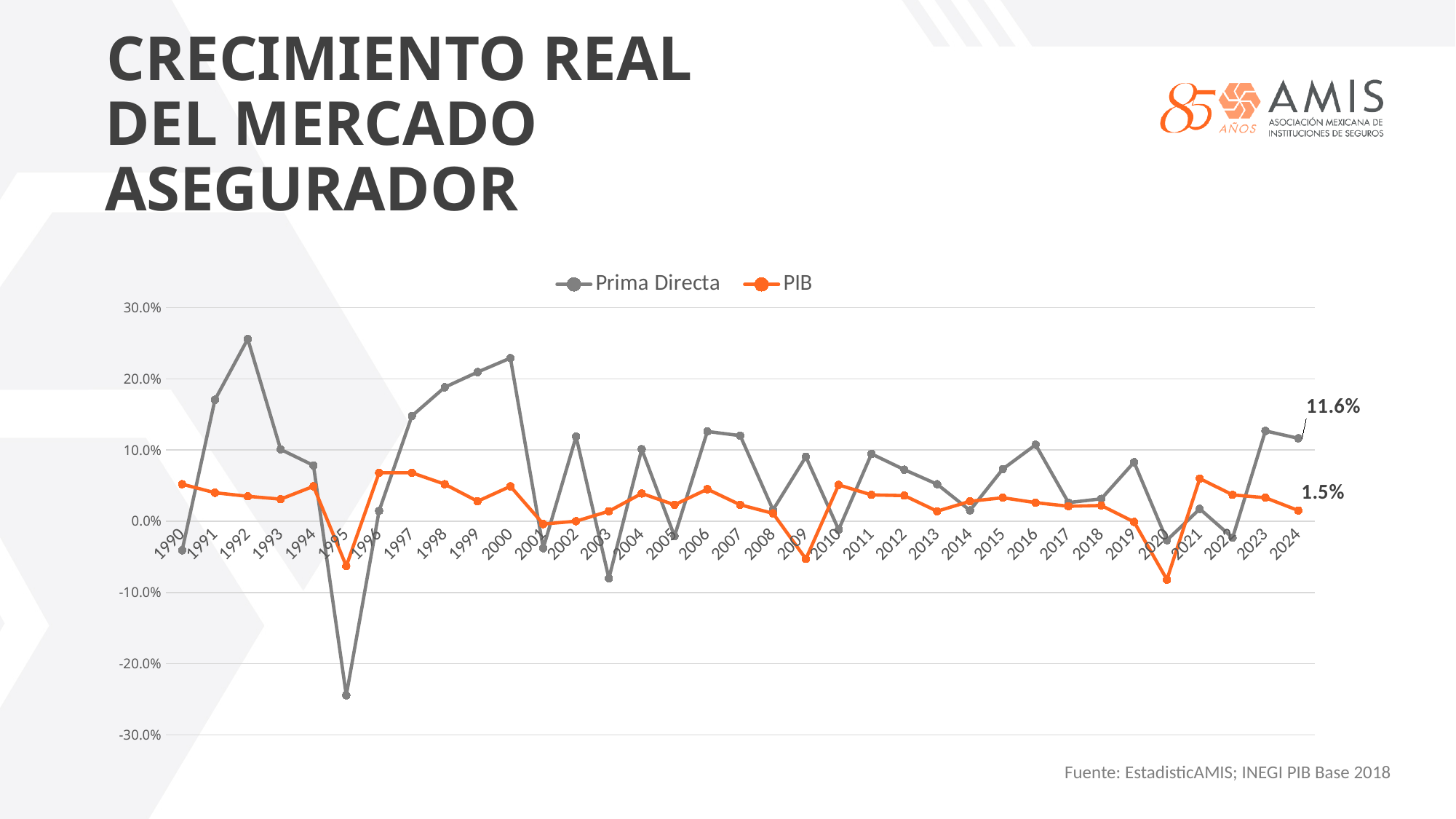
What is the difference between the Prima Directa and PIB values in 2024? 10.1 percentage points Is the PIB value for 2020 greater or less than 0.0%? less In which year does Prima Directa reach its highest value? 1992 In which year does Prima Directa reach its lowest value? 1995 What is the PIB value for 2024? 1.5% Is the Prima Directa value for 1992 greater or less than 20.0%? greater How many years are shown on the x axis? 35 Is the Prima Directa value for 1995 greater or less than -20.0%? less What kind of chart is shown on the slide? line chart What is the Prima Directa value for 2024? 11.6% In 2024, which series has the larger value, Prima Directa or PIB? Prima Directa How many series does the legend list? 2